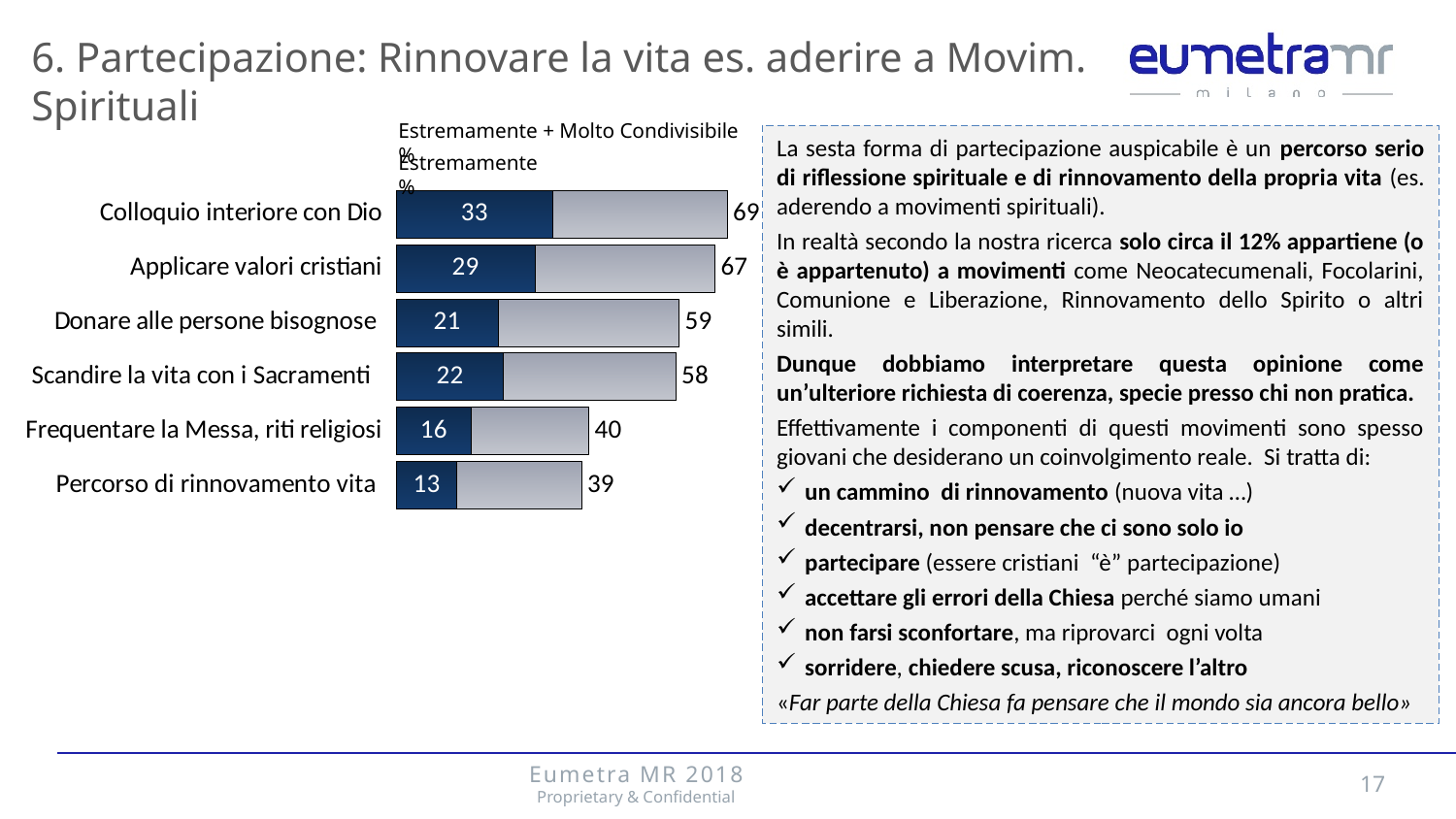
What is the 'Estremamente + Molto Condivisibile %' value for Frequentare la Messa, riti religiosi? 40 Which category has the highest 'Estremamente + Molto Condivisibile %' value? Colloquio interiore con Dio What is the difference between the 'Estremamente + Molto Condivisibile %' values for Colloquio interiore con Dio and Percorso di rinnovamento vita? 30 What kind of chart is shown on the slide? Bar chart How many categories are shown in the chart? 6 Which category has the lowest 'Estremamente %' value? Percorso di rinnovamento vita Which has a larger 'Estremamente %' value: Donare alle persone bisognose or Scandire la vita con i Sacramenti? Scandire la vita con i Sacramenti What is the difference between the 'Estremamente %' values for Applicare valori cristiani and Frequentare la Messa, riti religiosi? 13 What is the 'Estremamente + Molto Condivisibile %' value for Applicare valori cristiani? 67 What is the 'Estremamente %' value for Colloquio interiore con Dio? 33 What is the 'Estremamente %' value for Percorso di rinnovamento vita? 13